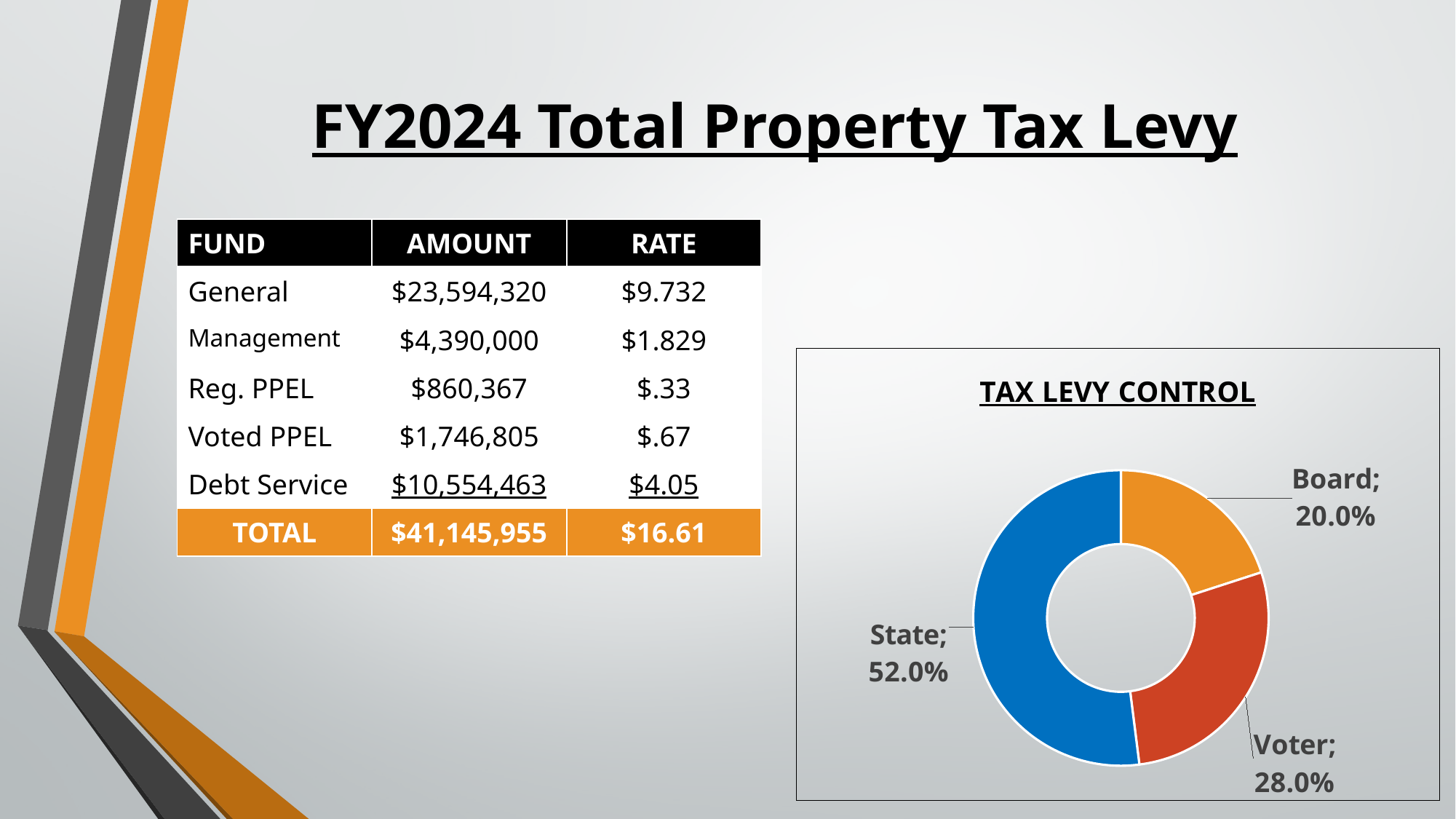
In the TAX LEVY CONTROL chart, what share is labelled for State? 52.0% What kind of chart is the TAX LEVY CONTROL chart? Doughnut (pie) chart Which slice of the TAX LEVY CONTROL chart is the largest? State In the TAX LEVY CONTROL chart, what share is labelled for Voter? 28.0% Which slice of the TAX LEVY CONTROL chart is the smallest? Board How many slices does the TAX LEVY CONTROL chart have? 3 In the TAX LEVY CONTROL chart, what is the combined share of Board and Voter? 48.0% In the TAX LEVY CONTROL chart, what share is labelled for Board? 20.0% In the TAX LEVY CONTROL chart, what is the difference in percentage points between the State and Voter shares? 24.0% In the TAX LEVY CONTROL chart, what colour is the State slice? Blue What is the title of the chart on the slide? TAX LEVY CONTROL In the TAX LEVY CONTROL chart, which is larger, the Voter share or the Board share? Voter